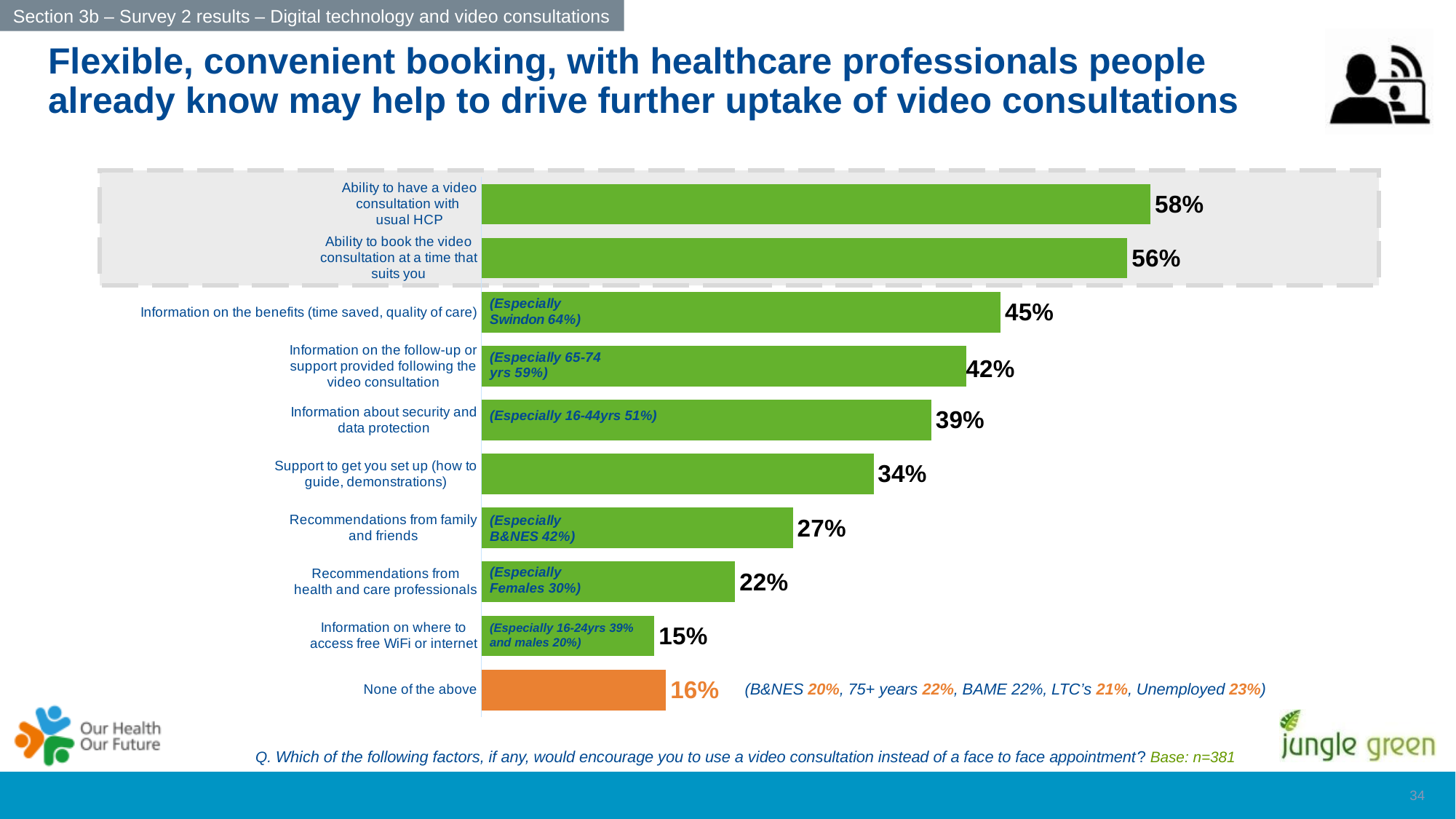
What percentage of respondents said the ability to have a video consultation with their usual HCP would encourage them to use a video consultation? 58% How many bars are shown in the chart? 10 What is the value for 'Information on the follow-up or support provided following the video consultation'? 42% What kind of chart is shown on the slide? Bar chart Which factor has the lowest percentage (excluding 'None of the above')? Information on where to access free WiFi or internet Which bar is coloured orange rather than green? None of the above What is the difference between 'Ability to have a video consultation with usual HCP' and 'Ability to book the video consultation at a time that suits you'? 2% What percentage selected 'None of the above'? 16% What is the value for 'Information about security and data protection'? 39% What is the difference between 'Information on the benefits (time saved, quality of care)' and 'Support to get you set up (how to guide, demonstrations)'? 11% Which is larger: 'Recommendations from family and friends' or 'Recommendations from health and care professionals'? Recommendations from family and friends Which factor has the highest percentage? Ability to have a video consultation with usual HCP